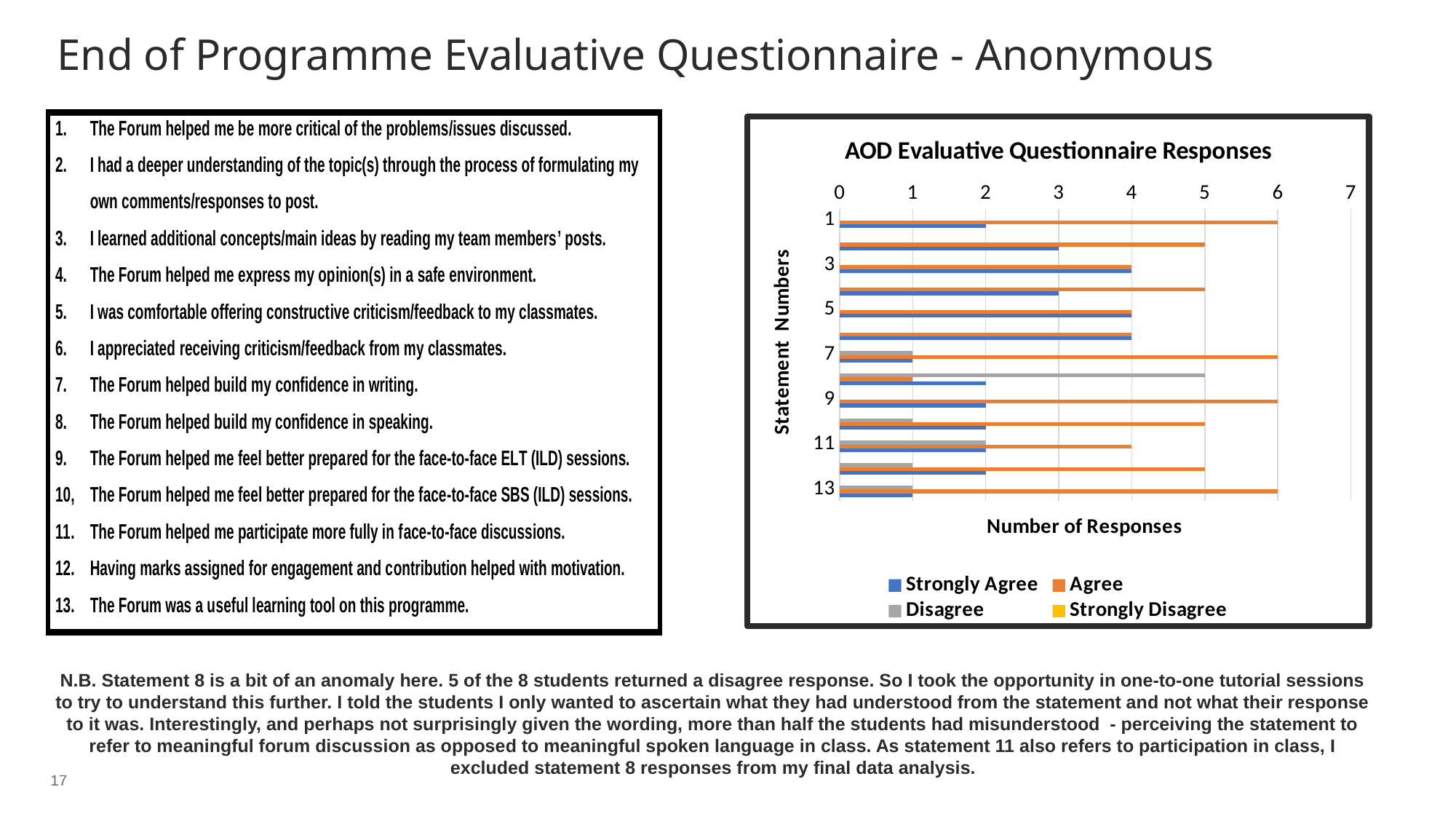
How many series does the chart legend list? 4 Is the number of Agree responses for statement 1 greater or less than 5? greater Which statement has more Strongly Agree responses, statement 1 or statement 3? Statement 3 What is the title of the chart? AOD Evaluative Questionnaire Responses What is the label of the horizontal axis of the chart? Number of Responses What type of chart is shown on the slide? Bar chart How many Strongly Agree responses did statement 3 receive? 4 How many statement numbers are plotted on the chart's vertical axis? 13 Is the number of Strongly Agree responses for statement 13 greater or less than 2? less How many Agree responses did statement 1 receive? 6 Which statement received the highest number of Disagree responses? Statement 8 How many Disagree responses did statement 8 receive? 5